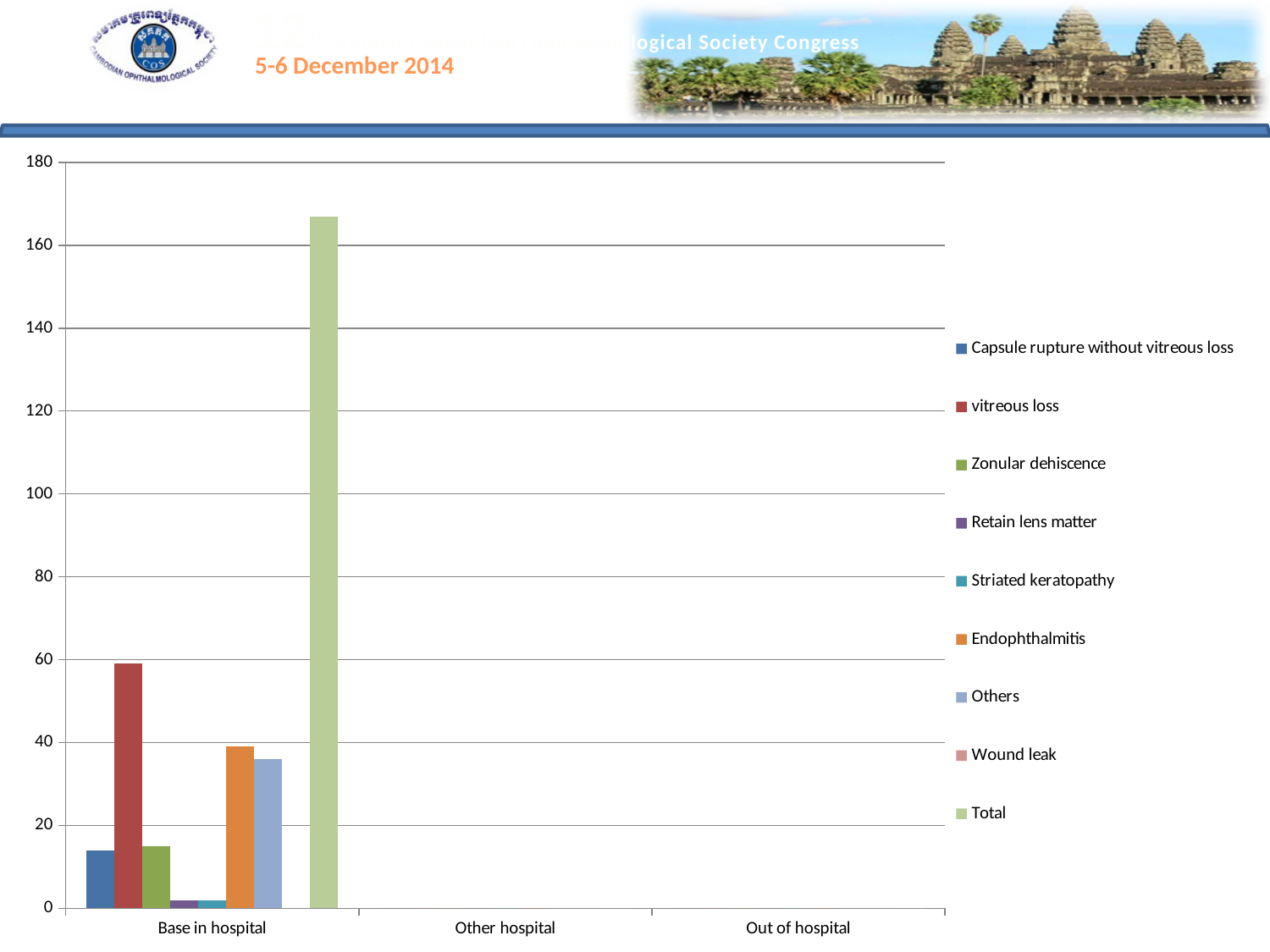
Which category on the x axis is listed last? Out of hospital What kind of chart is shown on the slide? bar chart How many series does the chart's legend list? 9 For Base in hospital, which is larger: Others or Zonular dehiscence? Others How many categories are shown on the x axis of the chart? 3 Is the Others value for Base in hospital greater or less than 40? less Is the Total value for Base in hospital greater or less than 160? greater Excluding the Total series, which series has the tallest bar for Base in hospital? vitreous loss Is the Capsule rupture without vitreous loss value for Base in hospital greater or less than 20? less For Base in hospital, which is larger: vitreous loss or Endophthalmitis? vitreous loss Which series has the tallest bar for Base in hospital? Total